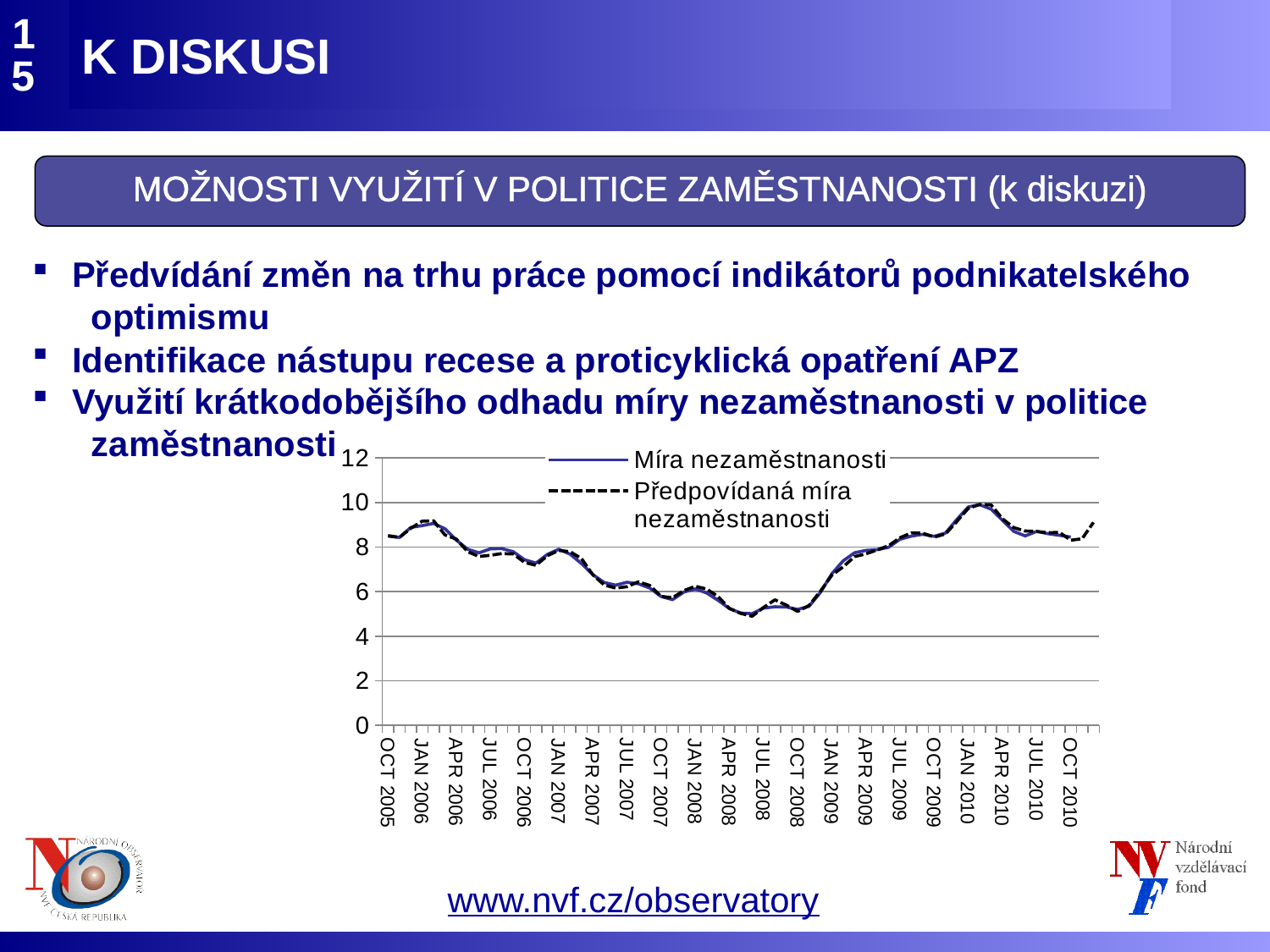
What is the highest value shown on the vertical axis? 12 Does Míra nezaměstnanosti rise or fall between JUL 2008 and JAN 2010? rise Is the value of Míra nezaměstnanosti at APR 2009 greater or less than 10? less Which series is drawn with a dashed line? Předpovídaná míra nezaměstnanosti Is the value of Míra nezaměstnanosti at JAN 2010 greater or less than 8? greater Does Míra nezaměstnanosti rise or fall between JAN 2007 and JUL 2008? fall Around which x-axis label does Míra nezaměstnanosti reach its lowest point? JUL 2008 What kind of chart is shown on the slide? line chart How many series does the chart legend list? 2 Is the value of Míra nezaměstnanosti at OCT 2005 greater or less than 8? greater What colour is the line for Míra nezaměstnanosti? blue